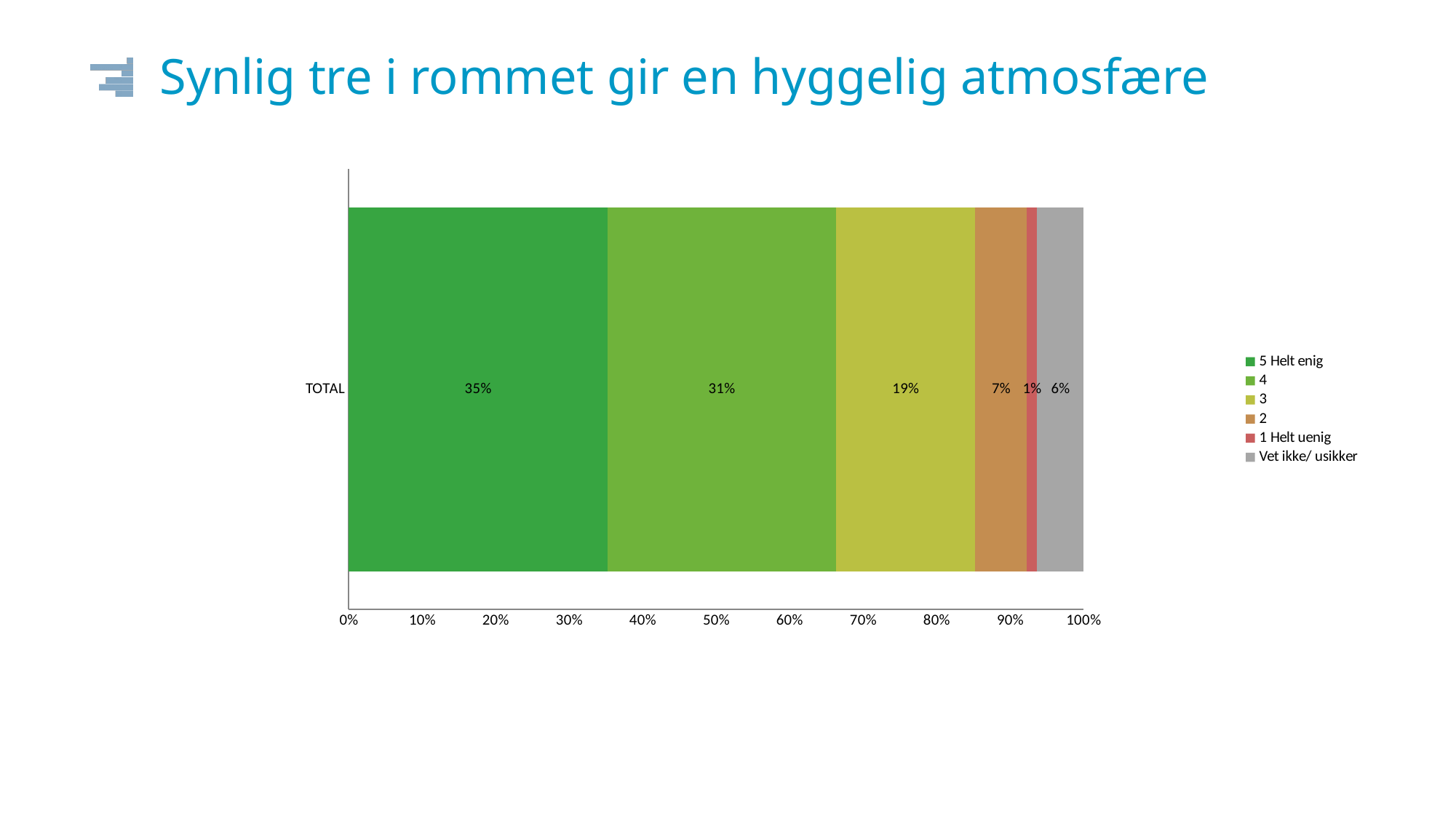
What percentage of respondents answered '5 Helt enig'? 35% Which response category has the smallest share? 1 Helt uenig What percentage of respondents answered 'Vet ikke/ usikker'? 6% How many series does the legend list? 6 What percentage of respondents answered '1 Helt uenig'? 1% What is the difference between the share for '5 Helt enig' and the share for '4'? 4% Which response category has the largest share? 5 Helt enig What kind of chart is shown on the slide? Stacked bar chart Which is larger, the share for '2' or the share for 'Vet ikke/ usikker'? 2 What percentage of respondents answered '4'? 31% What percentage of respondents answered '3'? 19% What percentage of respondents answered '2'? 7%